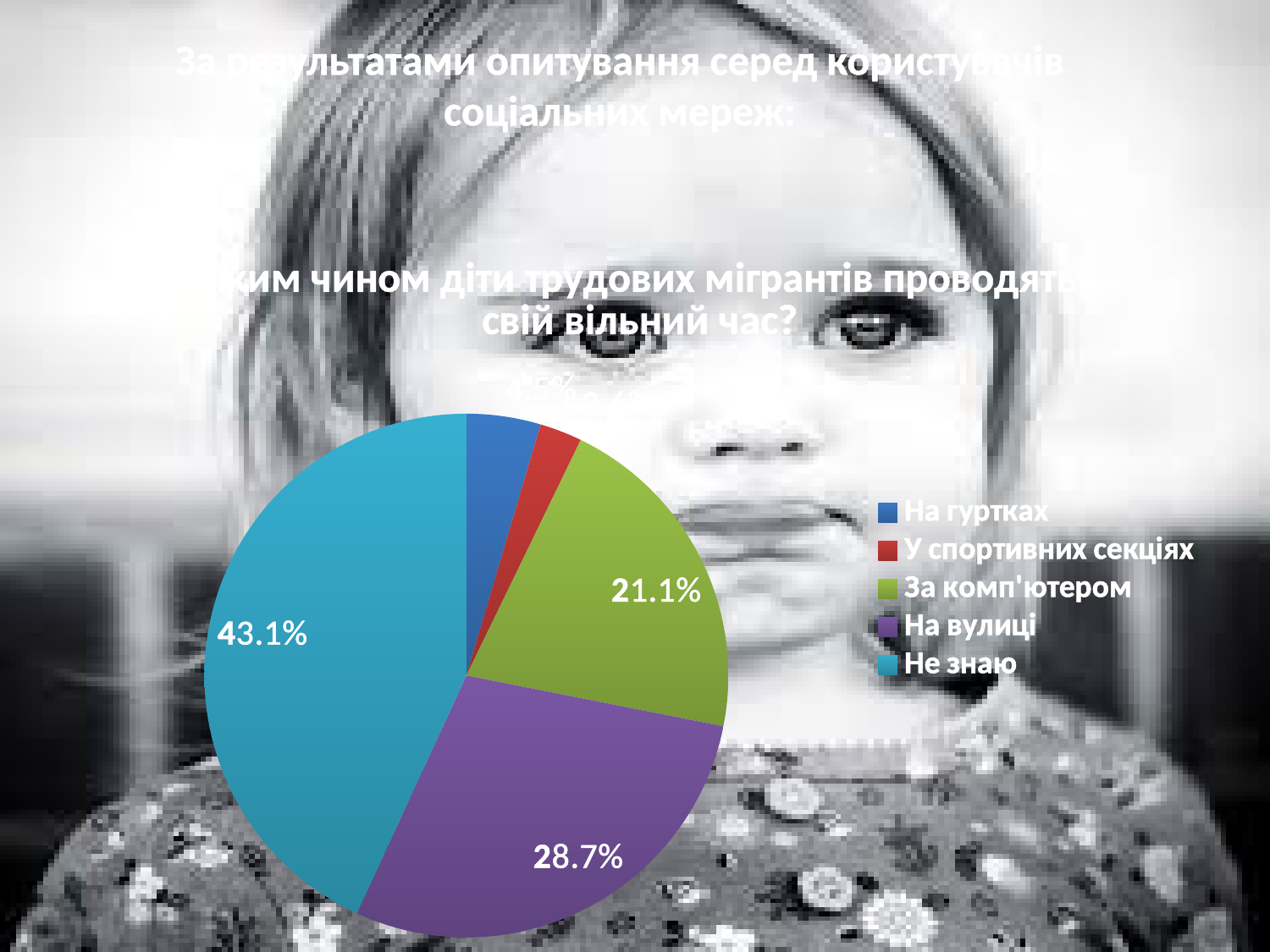
Which category has the largest slice of the pie? Не знаю What is the value shown for "За комп'ютером"? 21.1% Which category has the smallest slice of the pie? У спортивних секціях What is the value shown for "На вулиці"? 28.7% Which is larger, the slice for "Не знаю" or the slice for "На гуртках"? Не знаю What colour is the "За комп'ютером" slice? green What share of the pie does the "Не знаю" slice take? 43.1% What is the difference between the values for "На вулиці" and "За комп'ютером"? 7.6% Which is larger, the slice for "На вулиці" or the slice for "За комп'ютером"? На вулиці What is the difference between the values for "Не знаю" and "На вулиці"? 14.4% How many categories does the legend list? 5 What kind of chart is shown on the slide? pie chart